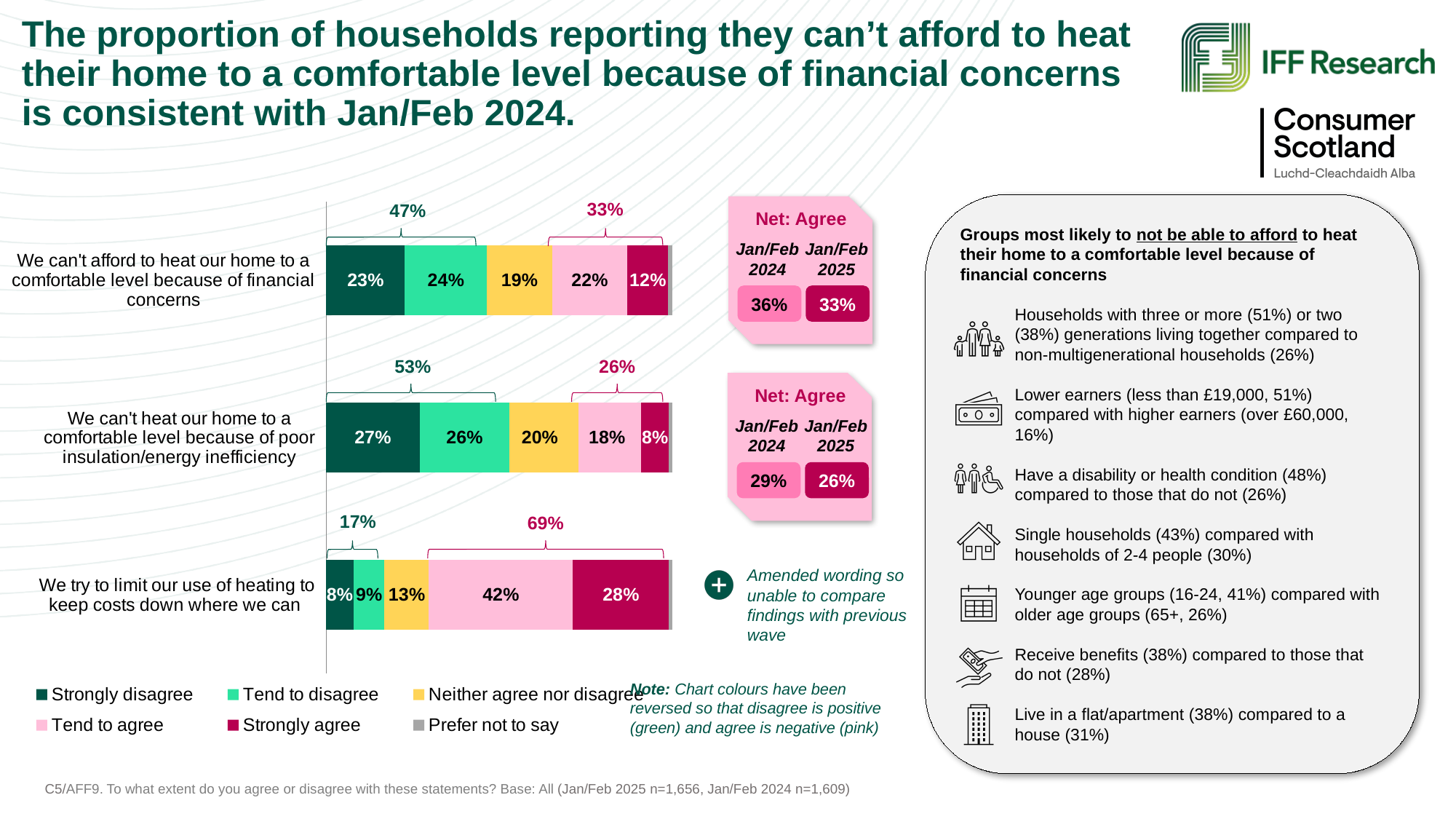
What kind of chart is shown on the slide? Stacked bar chart What is the combined 'Strongly disagree' plus 'Tend to disagree' percentage shown above the bar for the financial concerns statement? 47% Which statement has the lowest 'Strongly disagree' percentage? We try to limit our use of heating to keep costs down where we can What percentage of households 'Strongly agree' that they can't afford to heat their home to a comfortable level because of financial concerns? 12% What is the difference between the 'Tend to agree' percentages for the financial concerns statement (22%) and the poor insulation statement (18%)? 4 percentage points How many statements (categories) are plotted in the chart? 3 For the poor insulation/energy inefficiency statement, which is larger: 'Tend to disagree' or 'Neither agree nor disagree'? Tend to disagree What percentage 'Strongly disagree' that they can't heat their home to a comfortable level because of poor insulation/energy inefficiency? 27% What percentage 'Tend to agree' that they try to limit their use of heating to keep costs down where they can? 42% How many series does the chart legend list? 6 What was the Net: Agree figure for the financial concerns statement in Jan/Feb 2024? 36% Which statement has the highest 'Strongly agree' percentage? We try to limit our use of heating to keep costs down where we can